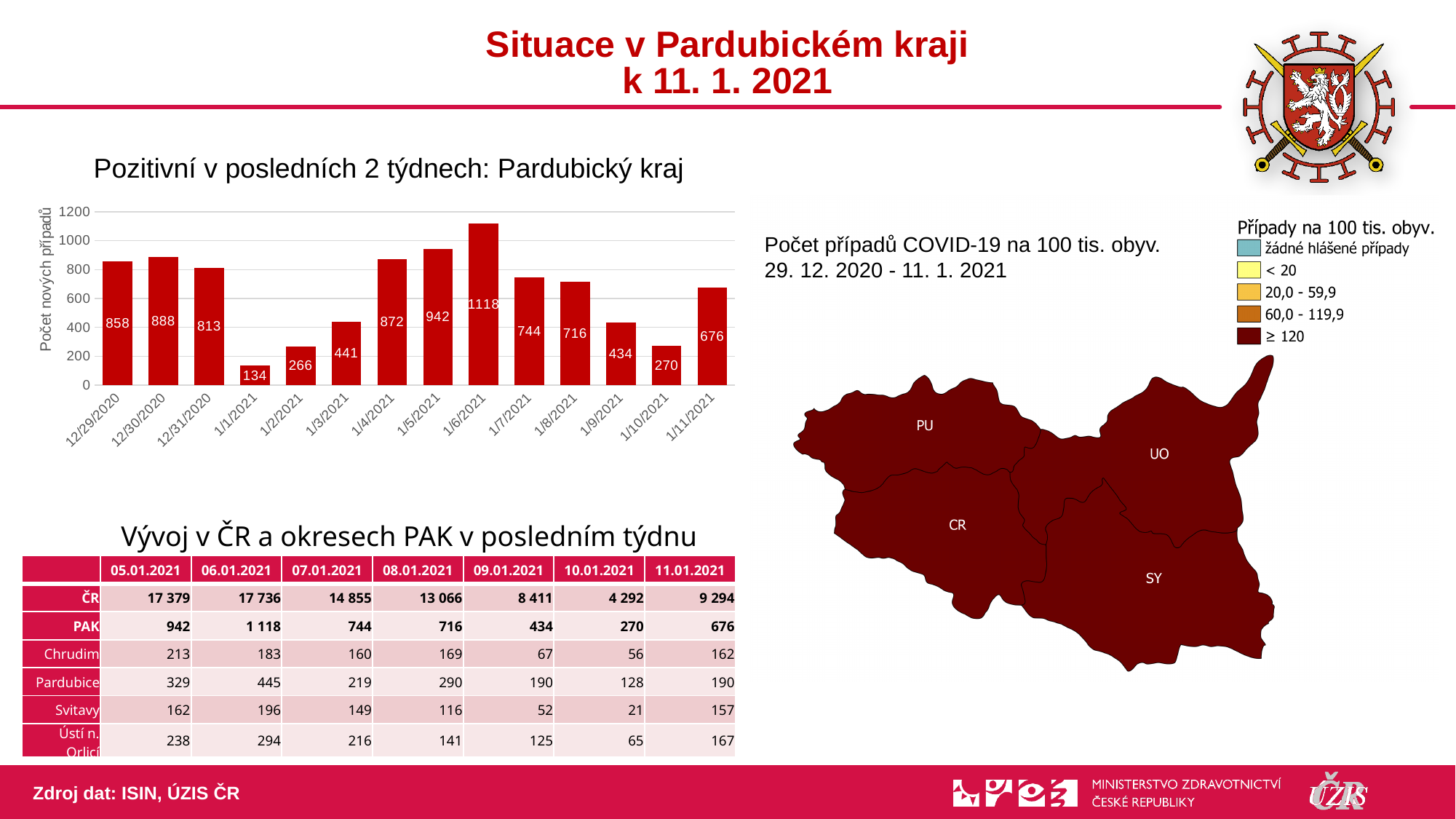
In the chart 'Pozitivní v posledních 2 týdnech: Pardubický kraj', which date has the highest value? 1/6/2021 In the chart 'Pozitivní v posledních 2 týdnech: Pardubický kraj', which date has the lowest value? 1/1/2021 In the chart 'Pozitivní v posledních 2 týdnech: Pardubický kraj', what is the value for 12/29/2020? 858 In the chart 'Pozitivní v posledních 2 týdnech: Pardubický kraj', what is the value for 1/6/2021? 1118 What is the label of the vertical axis in the chart 'Pozitivní v posledních 2 týdnech: Pardubický kraj'? Počet nových případů In the chart 'Pozitivní v posledních 2 týdnech: Pardubický kraj', which is larger, the value for 1/7/2021 or for 1/8/2021? 1/7/2021 In the chart 'Pozitivní v posledních 2 týdnech: Pardubický kraj', what is the value for 1/11/2021? 676 In the chart 'Pozitivní v posledních 2 týdnech: Pardubický kraj', what is the difference between the values for 1/5/2021 and 1/4/2021? 70 In the chart 'Pozitivní v posledních 2 týdnech: Pardubický kraj', is the value for 1/10/2021 greater or less than 400? less What type of chart is used to show 'Pozitivní v posledních 2 týdnech: Pardubický kraj'? bar chart In the chart 'Pozitivní v posledních 2 týdnech: Pardubický kraj', what is the difference between the values for 1/6/2021 and 1/1/2021? 984 How many dates (bars) are shown in the chart 'Pozitivní v posledních 2 týdnech: Pardubický kraj'? 14